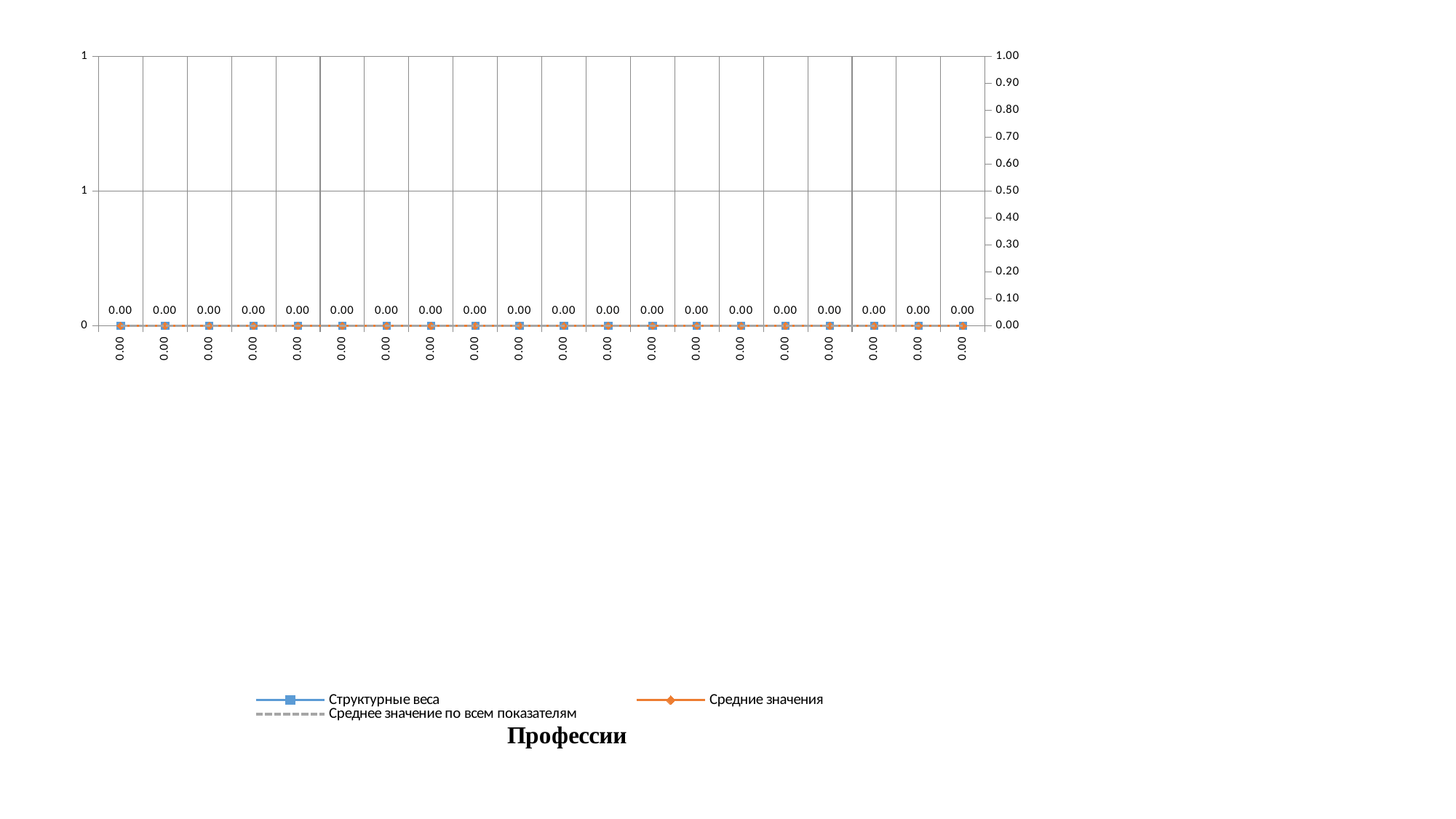
What kind of chart is shown on the slide? line chart What value do the data labels above the points show? 0.00 How many data points are plotted along the x axis? 20 Is the value for the first point greater or less than 0.50? less How many series does the legend list? 3 Is the value for the last point greater or less than 0.10? less What title is shown below the chart? Профессии What are the names of the series listed in the legend? Структурные веса, Средние значения, Среднее значение по всем показателям Do the plotted values rise, fall, or stay flat along the x axis? stay flat